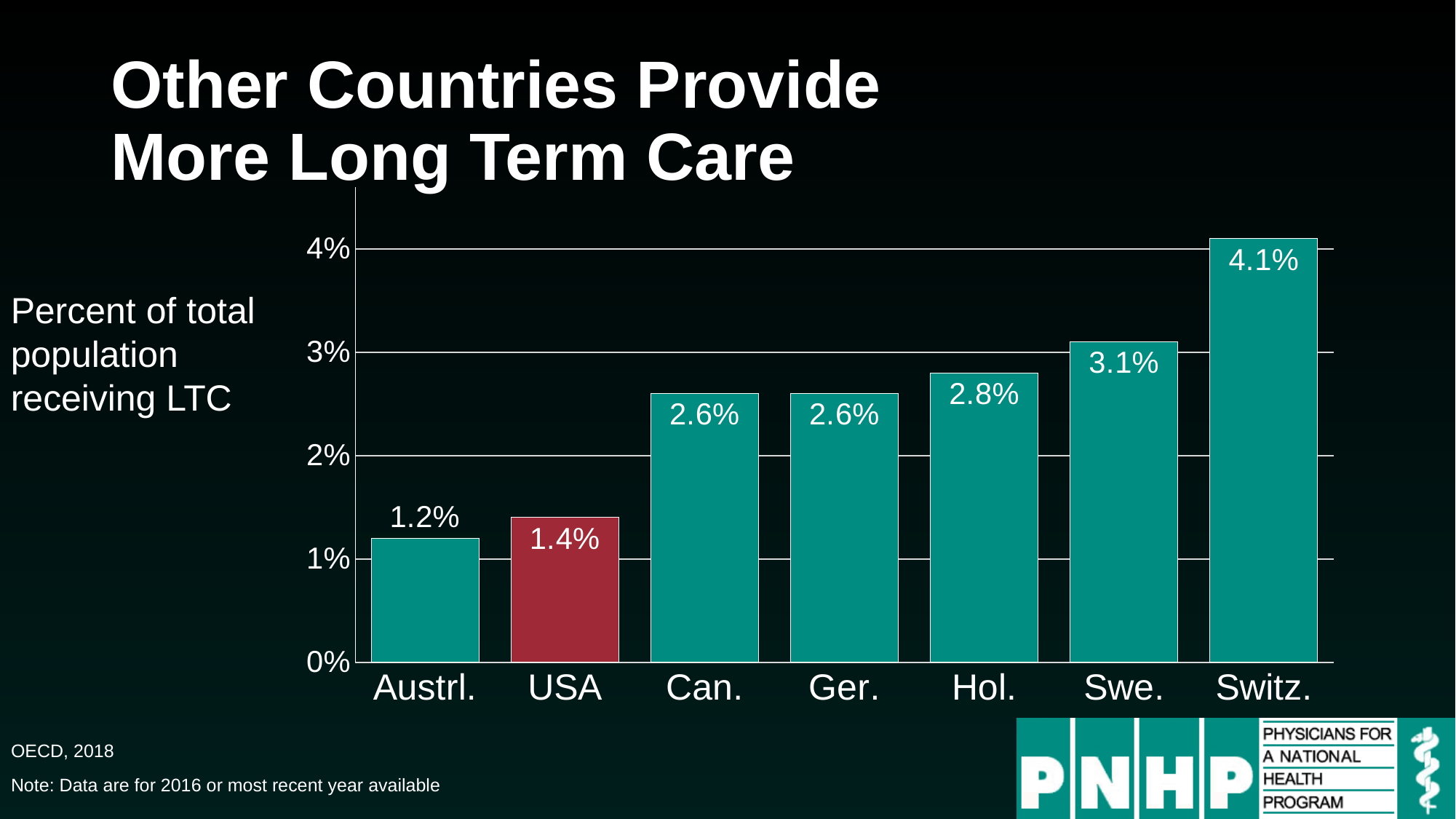
What is the value for USA? 1.4% What is the difference between the values for Swe. and Hol.? 0.3% How many countries are shown in the chart? 7 What is the value for Hol.? 2.8% Is the value for Can. greater or less than 2%? greater Which country has the lowest value? Austrl. Which bar is coloured differently (red) from the others? USA What is the value for Switz.? 4.1% Which country has the highest value? Switz. What kind of chart is shown on the slide? bar chart What is the difference between the values for Switz. and USA? 2.7% Which is larger, the value for Swe. or the value for Ger.? Swe.